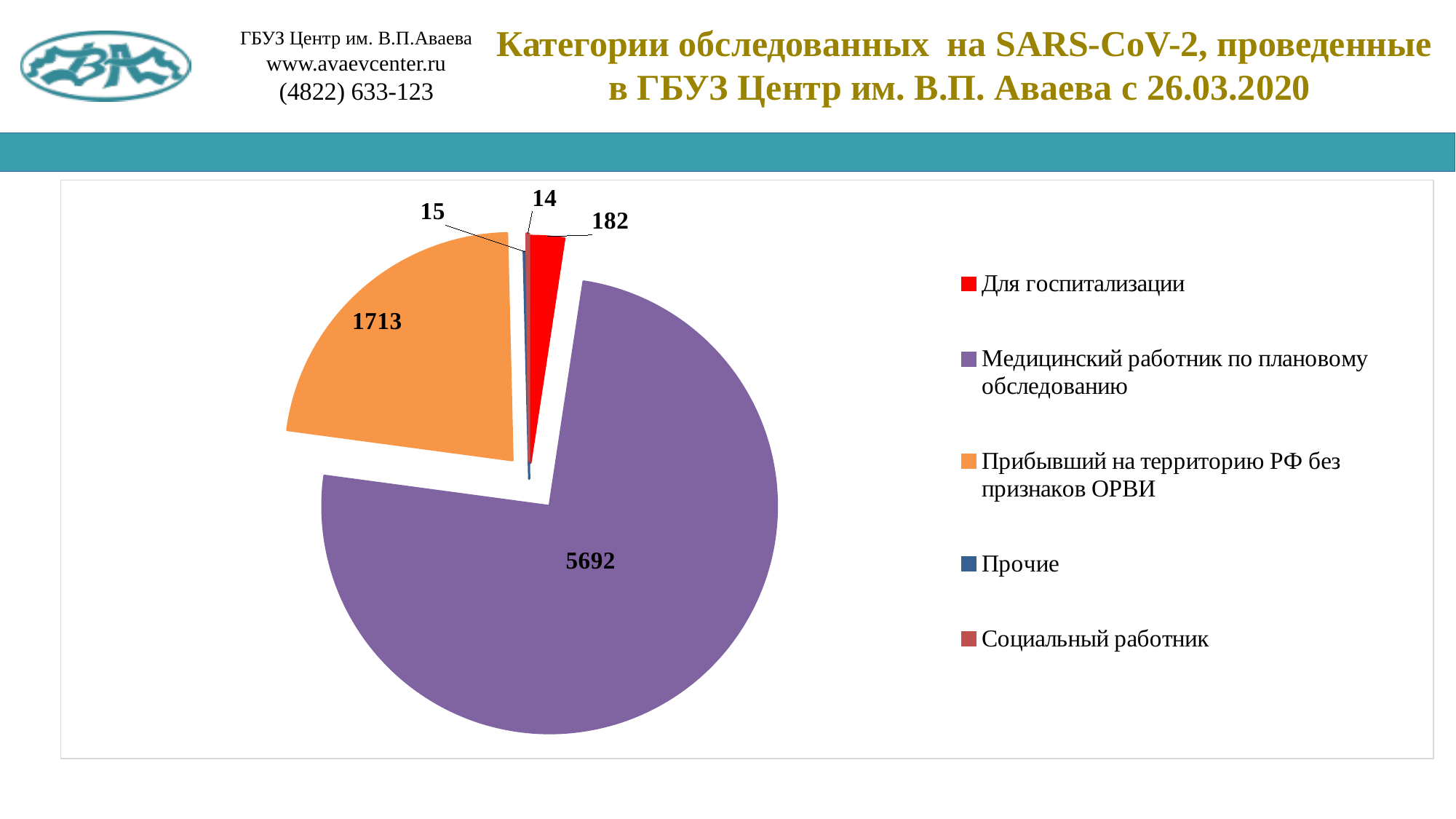
What is the value for 'Социальный работник'? 14 What is the difference between the values for 'Медицинский работник по плановому обследованию' and 'Прибывший на территорию РФ без признаков ОРВИ'? 3979 What is the total of all the values shown on the pie chart? 7616 What is the difference between the values for 'Для госпитализации' and 'Прочие'? 167 What is the value for 'Медицинский работник по плановому обследованию'? 5692 What kind of chart is shown on the slide? pie chart What is the value for 'Для госпитализации'? 182 What is the value for 'Прибывший на территорию РФ без признаков ОРВИ'? 1713 How many categories does the legend of the pie chart list? 5 What colour is the slice for 'Для госпитализации'? red Which category has the largest slice of the pie? Медицинский работник по плановому обследованию Which is larger: the value for 'Для госпитализации' or the value for 'Прибывший на территорию РФ без признаков ОРВИ'? Прибывший на территорию РФ без признаков ОРВИ